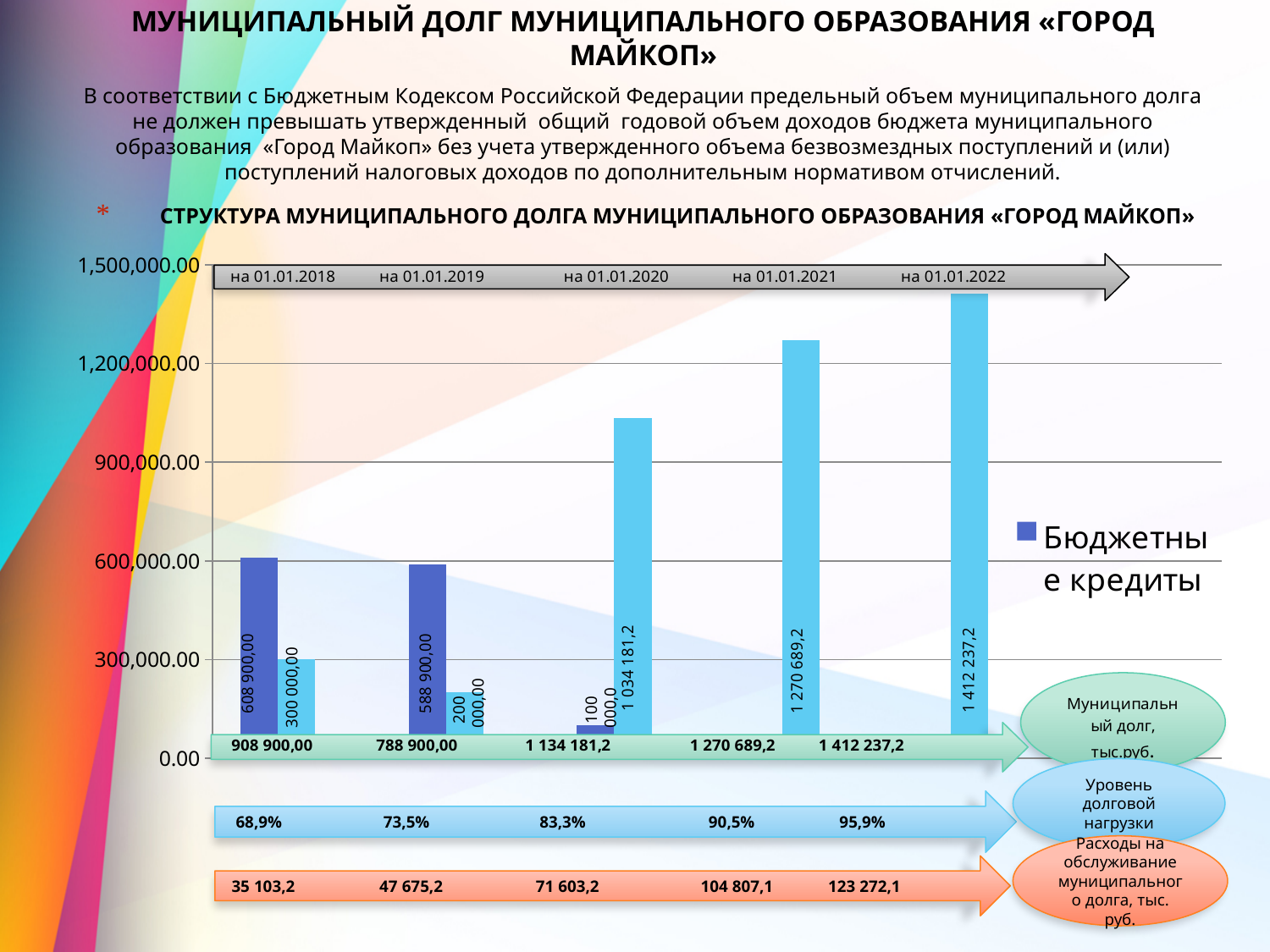
What is the total Муниципальный долг, тыс.руб. shown for на 01.01.2020? 1 134 181,2 Is the value of the light blue bar на 01.01.2021 greater or less than 1,200,000.00? greater What is the value of Бюджетные кредиты на 01.01.2018? 608 900,00 On which date is the light blue bar the tallest? на 01.01.2022 What is the difference between Бюджетные кредиты на 01.01.2018 and на 01.01.2019? 20 000,00 What is the Уровень долговой нагрузки shown for на 01.01.2022? 95,9% What is the value of the light blue bar на 01.01.2022? 1 412 237,2 На 01.01.2018, which is larger: the Бюджетные кредиты bar or the light blue bar? Бюджетные кредиты Do the light blue bars rise or fall from на 01.01.2020 to на 01.01.2022? rise How many dates are shown on the x axis of the chart? 5 What kind of chart is shown on the slide? bar chart